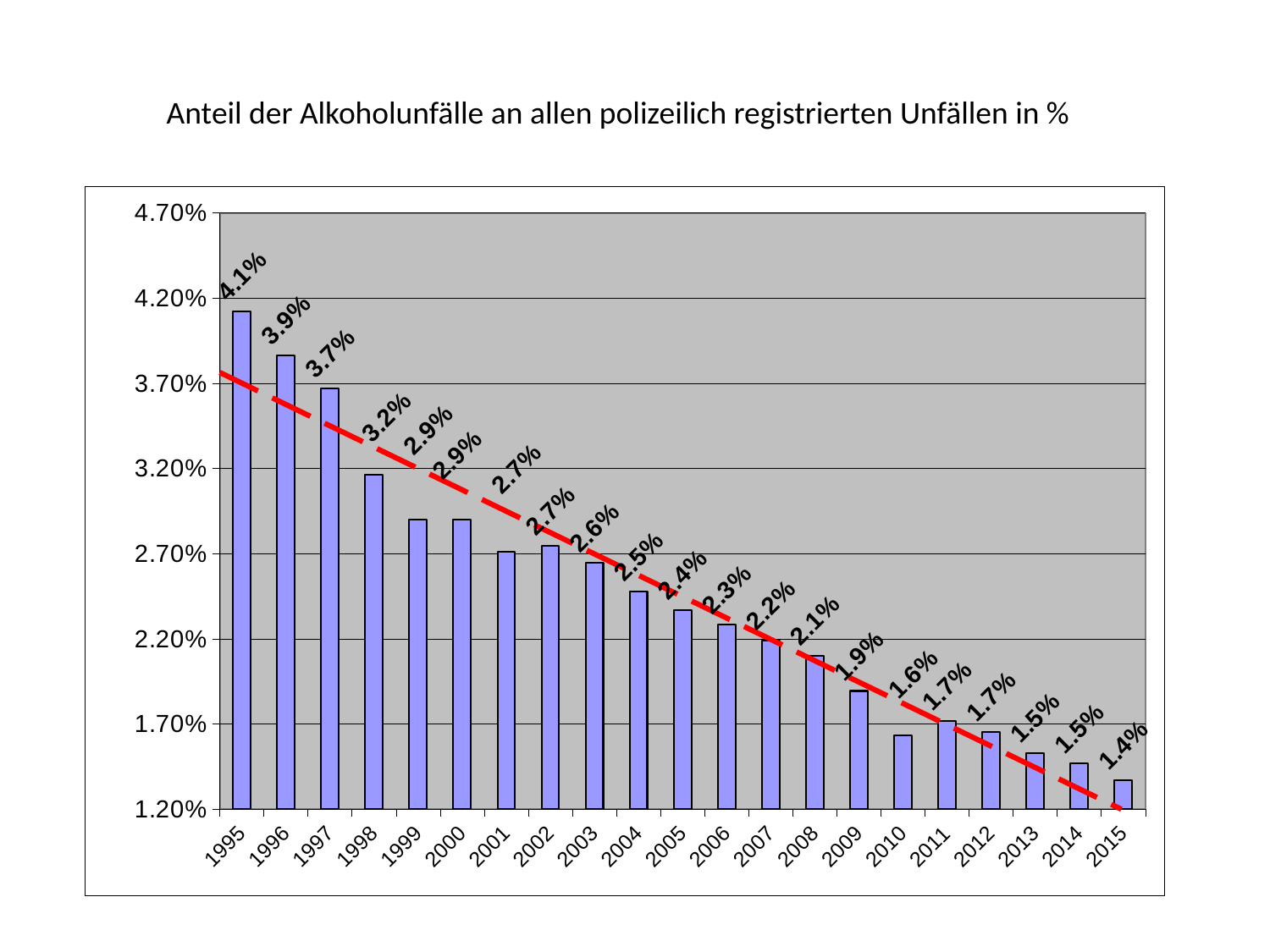
Which year has the lowest value? 2015 Which year has the highest value? 1995 What is the value for 2015? 1.4% Is the value for 2009 greater or less than 2.20%? less Which is larger, the value for 1998 or the value for 2004? 1998 What is the value for 2003? 2.6% What kind of chart is this? bar chart What is the difference between the values for 1995 and 2015? 2.7% What is the value for 1995? 4.1% Do the values generally rise or fall from 1995 to 2015? fall What is the value for 2010? 1.6% How many years are shown on the x axis? 21